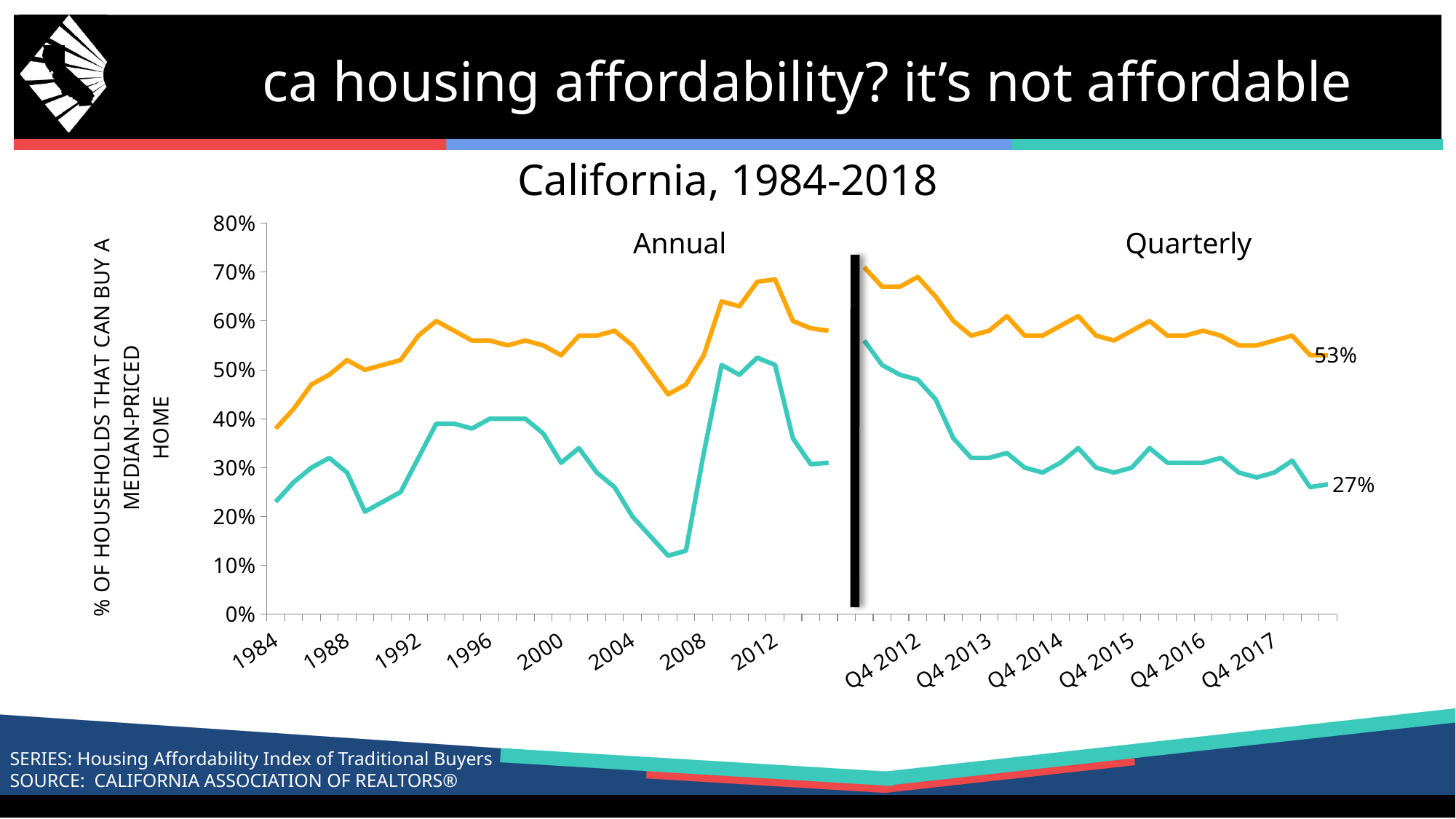
Is the value of the teal line in 1984 greater or less than 30%? less What is the final labelled value of the orange line in the Quarterly section? 53% Does the teal line rise or fall between 2004 and 2007? fall What is the final labelled value of the teal line in the Quarterly section? 27% At the end of the Quarterly section, which line has the higher value, the orange line or the teal line? the orange line Is the lowest point of the teal line, around 2007-2008, greater or less than 20%? less Is the value of the orange line in 2012 greater or less than 60%? greater What kind of chart is shown on the slide? line chart What is the title of the chart? California, 1984-2018 How many lines are plotted on the chart? 2 What is the difference between the final labelled values of the orange line (53%) and the teal line (27%)? 26 percentage points